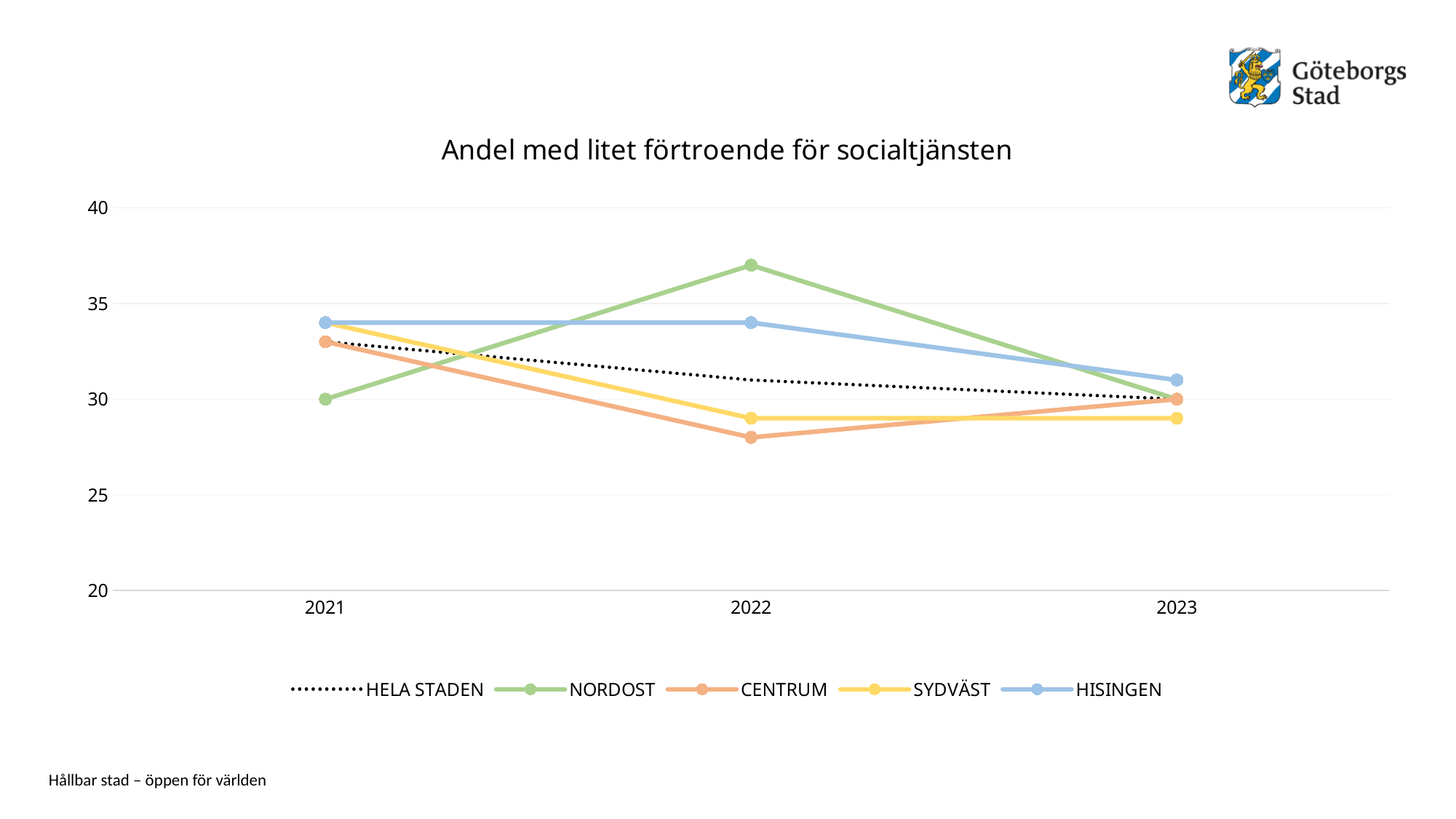
Which series has the lowest value in 2021? NORDOST Does the HELA STADEN line rise or fall from 2021 to 2023? fall Is the value for NORDOST in 2022 greater or less than 35? greater What is the title of the chart? Andel med litet förtroende för socialtjänsten How many series does the legend list? 5 What kind of chart is shown on the slide? line chart How many years are shown on the x axis? 3 Is the value for CENTRUM in 2022 greater or less than 30? less Which series has the highest value in 2022? NORDOST In 2022, which is larger: NORDOST or HISINGEN? NORDOST What is the value for NORDOST in 2021? 30 What is the value for CENTRUM in 2023? 30